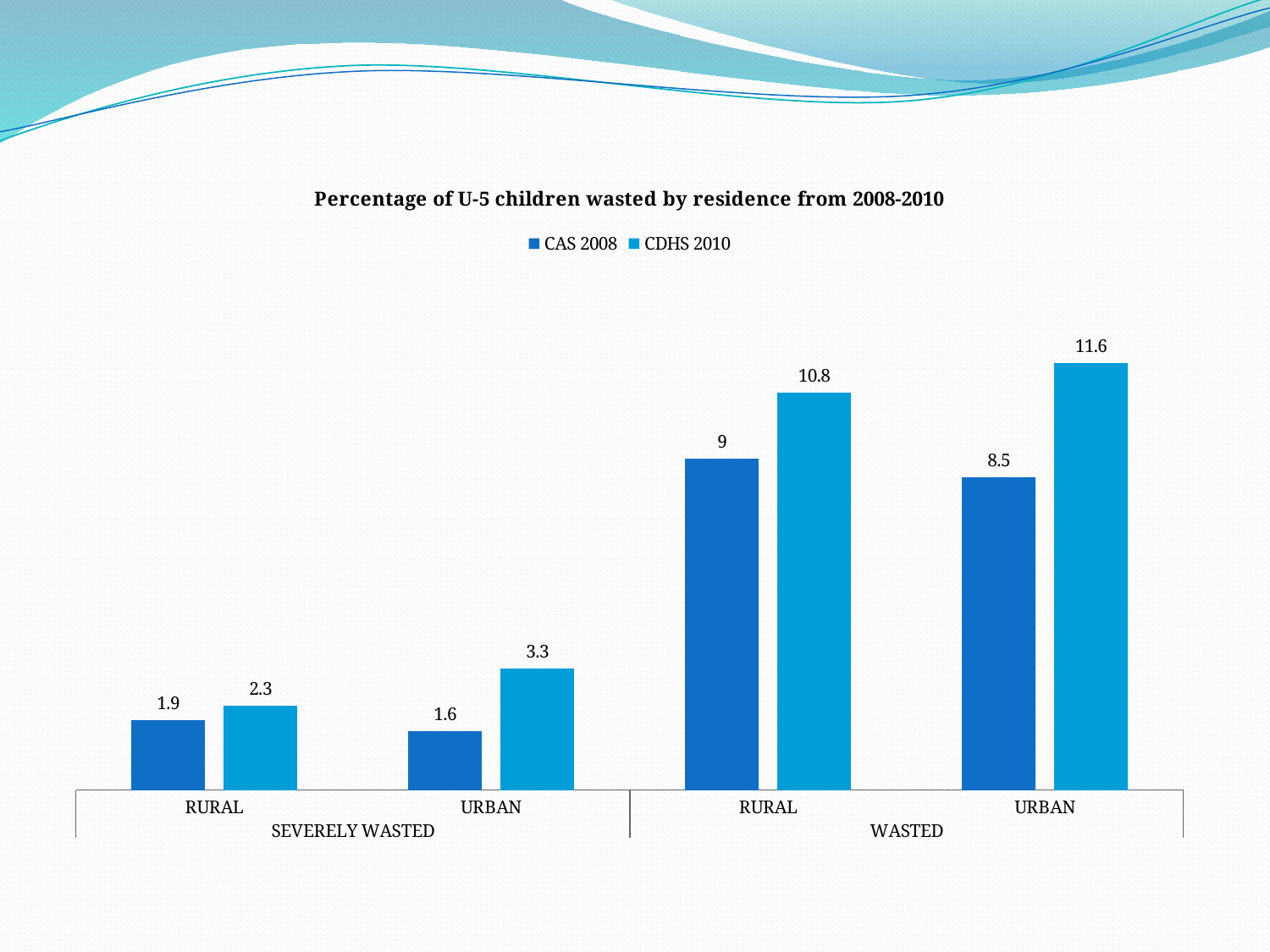
What is the CDHS 2010 value for Urban under Wasted? 11.6 What is the difference between the CDHS 2010 and CAS 2008 values for Urban under Severely Wasted? 1.7 Which is larger: the CAS 2008 value for Rural under Wasted or the CAS 2008 value for Urban under Wasted? Rural under Wasted What is the CAS 2008 value for Rural under Severely Wasted? 1.9 Which category has the highest CDHS 2010 value? Urban (Wasted) What is the title of the chart? Percentage of U-5 children wasted by residence from 2008-2010 What kind of chart is shown on the slide? Bar chart How many series does the legend list? 2 What is the difference between the CDHS 2010 and CAS 2008 values for Urban under Wasted? 3.1 What is the CAS 2008 value for Urban under Severely Wasted? 1.6 What is the CDHS 2010 value for Rural under Wasted? 10.8 Which category has the lowest CAS 2008 value? Urban (Severely Wasted)